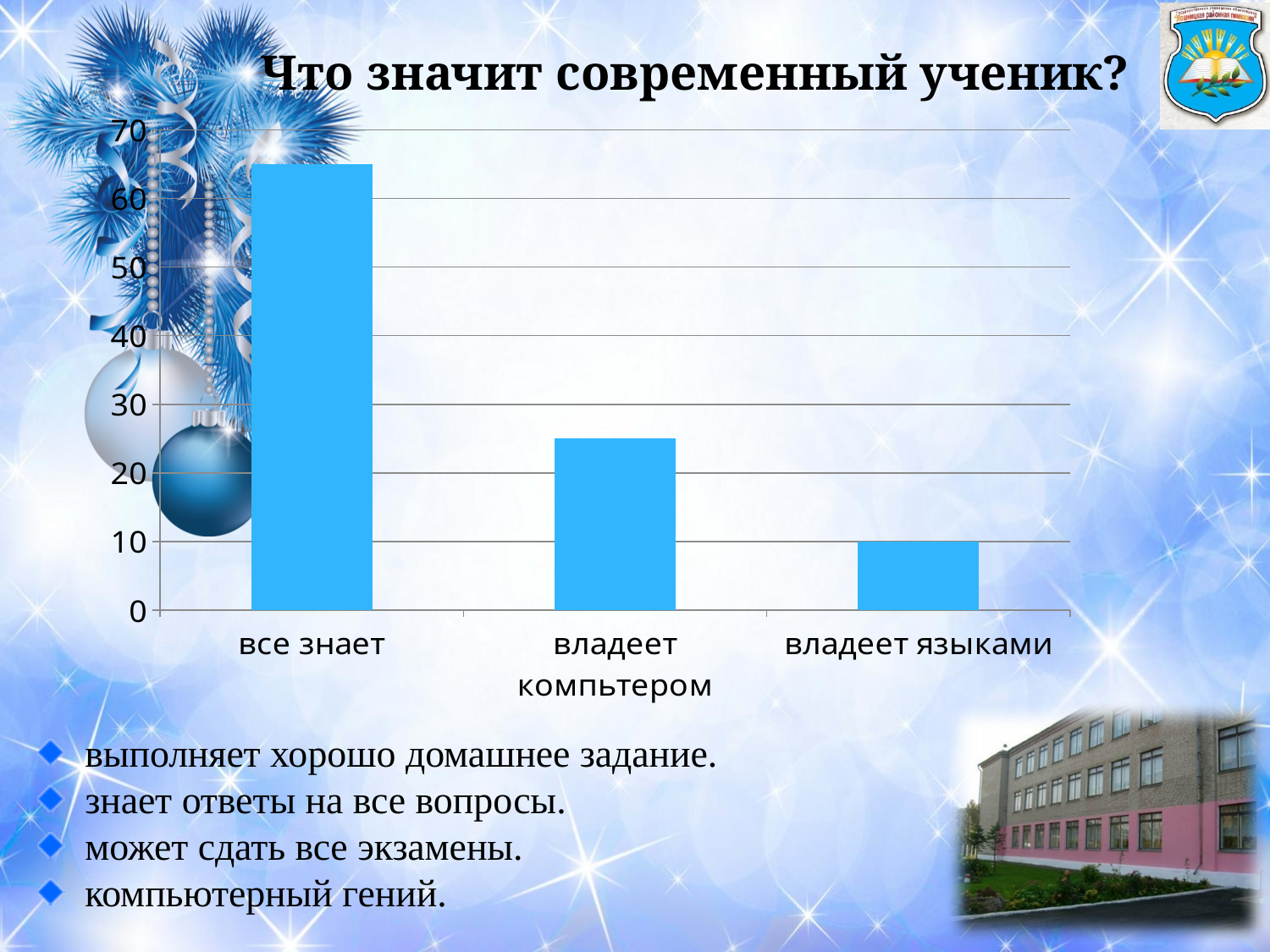
Which category has the highest bar? все знает What is the highest tick value shown on the vertical axis? 70 Is the value for "владеет компьтером" greater or less than 30? less Which is larger, the value for "все знает" or the value for "владеет компьтером"? все знает Which is larger, the value for "владеет компьтером" or the value for "владеет языками"? владеет компьтером How many categories does the chart show? 3 Is the value for "владеет компьтером" greater or less than 20? greater Do the bar values rise or fall from left to right along the x axis? fall What kind of chart is shown on the slide? bar chart Which category has the lowest bar? владеет языками Is the value for "все знает" greater or less than 60? greater